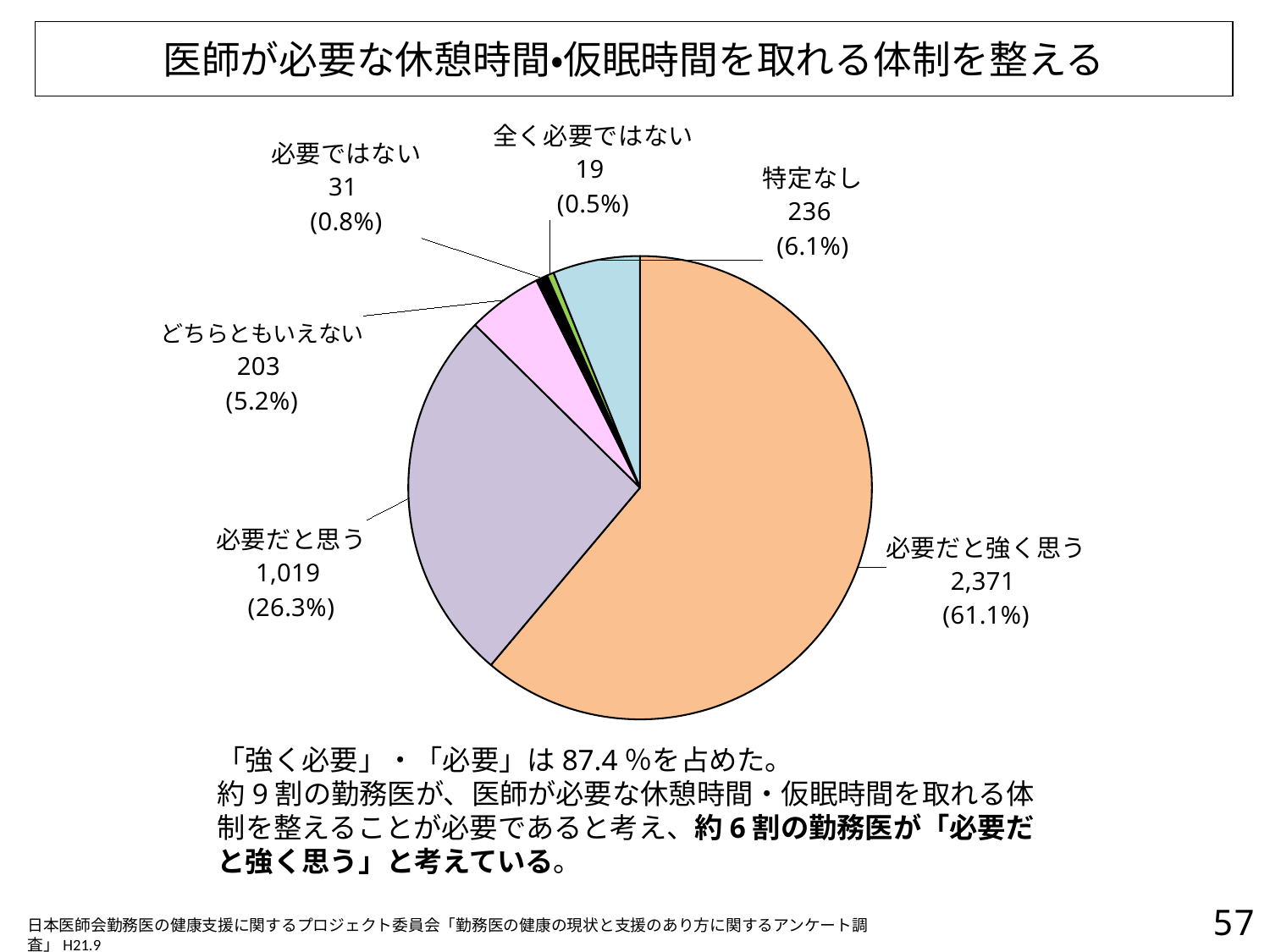
Which is larger, the count for 特定なし or the count for どちらともいえない? 特定なし What is the count for どちらともいえない? 203 What is the title of the slide containing the pie chart? 医師が必要な休憩時間•仮眠時間を取れる体制を整える What is the difference in count between 必要だと強く思う and 必要だと思う? 1,352 Which category has the largest slice? 必要だと強く思う What percentage share does 必要だと思う have? 26.3% What is the count for 必要だと強く思う? 2,371 What type of chart is shown on the slide? pie chart Which category has the smallest slice? 全く必要ではない How many categories (slices) does the pie chart have? 6 What percentage share does 特定なし have? 6.1% What is the count for 必要ではない? 31